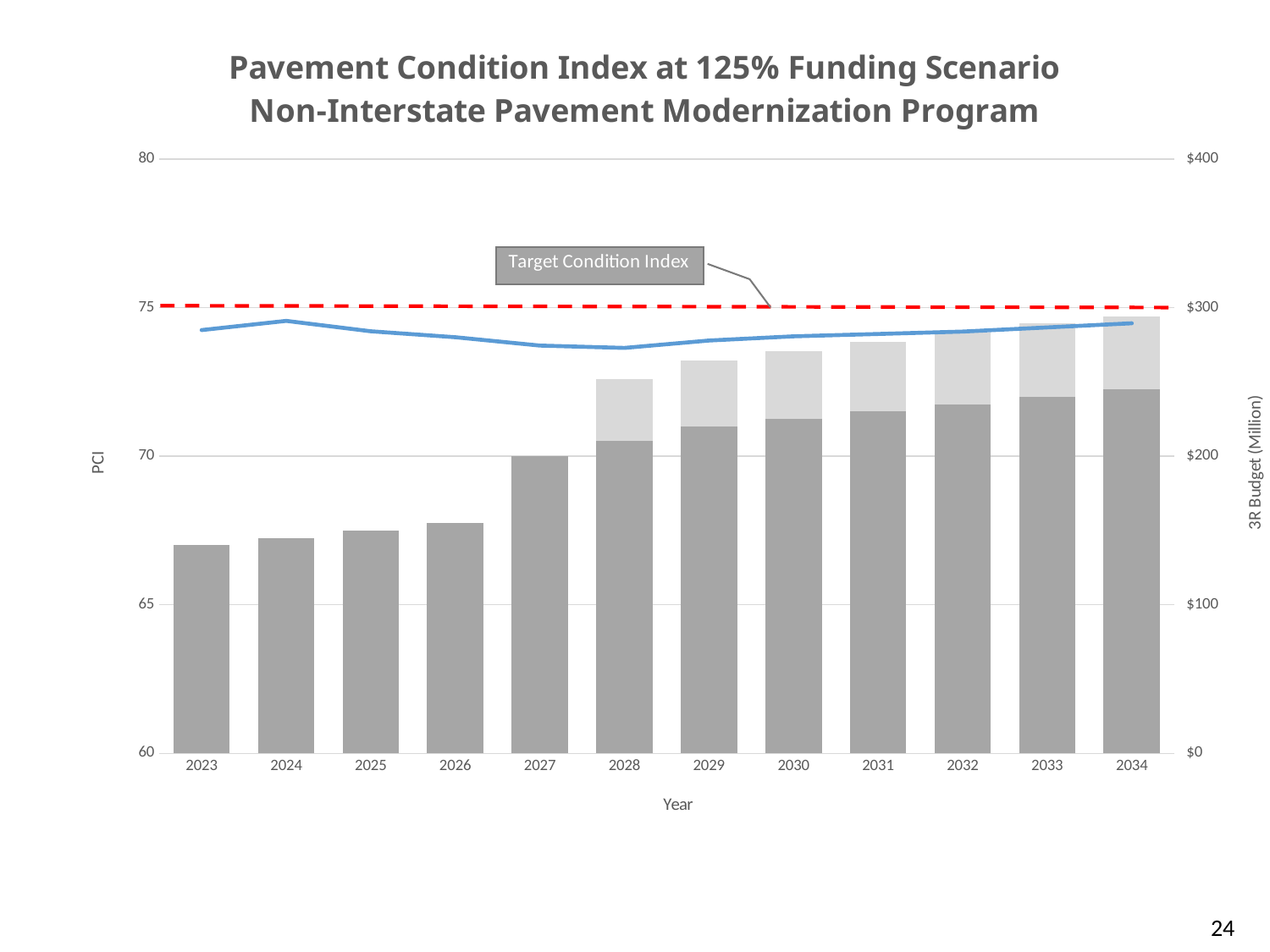
Which year has the shortest bar? 2023 How many years are shown on the x axis? 12 Which year has the larger total bar, 2027 or 2028? 2028 Do the dark gray bars rise or fall from 2023 to 2034? rise What is the title of the right-hand vertical axis? 3R Budget (Million) Is the bar for 2023 greater or less than $200? less Is the total stacked bar for 2034 greater or less than $200? greater Which year has the tallest stacked bar? 2034 At what PCI value is the dashed Target Condition Index line drawn? 75 What kind of chart is shown on the slide? combination bar and line chart Is the PCI line value for 2023 greater or less than 75? less What is the 3R Budget value of the bar for 2027? $200